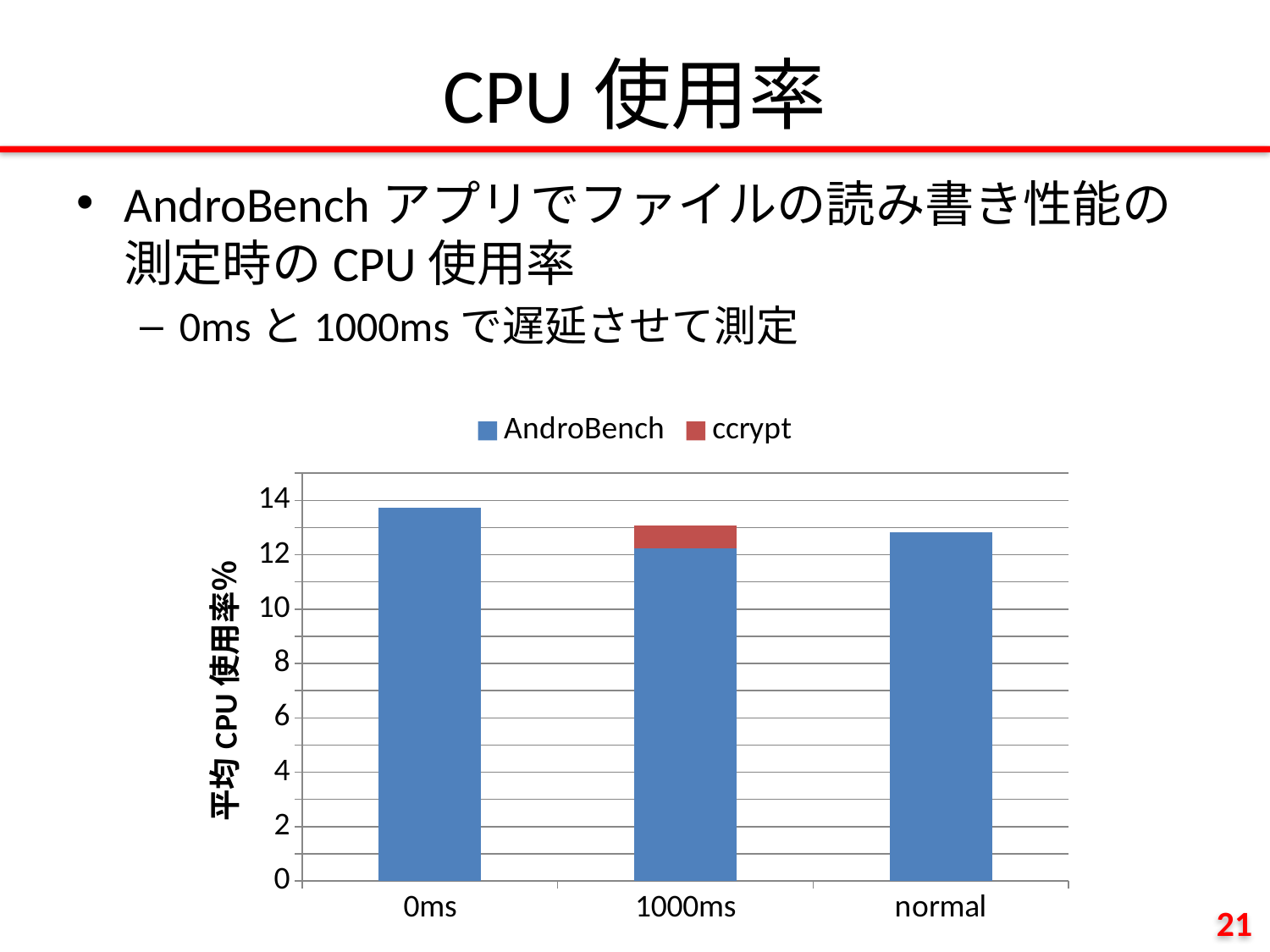
Is the ccrypt value for 1000ms greater or less than 2? less What kind of chart is shown on the slide? bar chart Is the AndroBench value for normal greater or less than 12? greater Which category has the highest AndroBench value? 0ms What are the two series listed in the chart's legend? AndroBench and ccrypt How many series does the chart's legend list? 2 Is the AndroBench value for 0ms greater or less than 12? greater What is the label of the vertical axis of the chart? 平均 CPU 使用率% How many categories are shown on the x axis of the chart? 3 Which is larger, the AndroBench value for 0ms or for 1000ms? 0ms Which category has the lowest AndroBench value? 1000ms